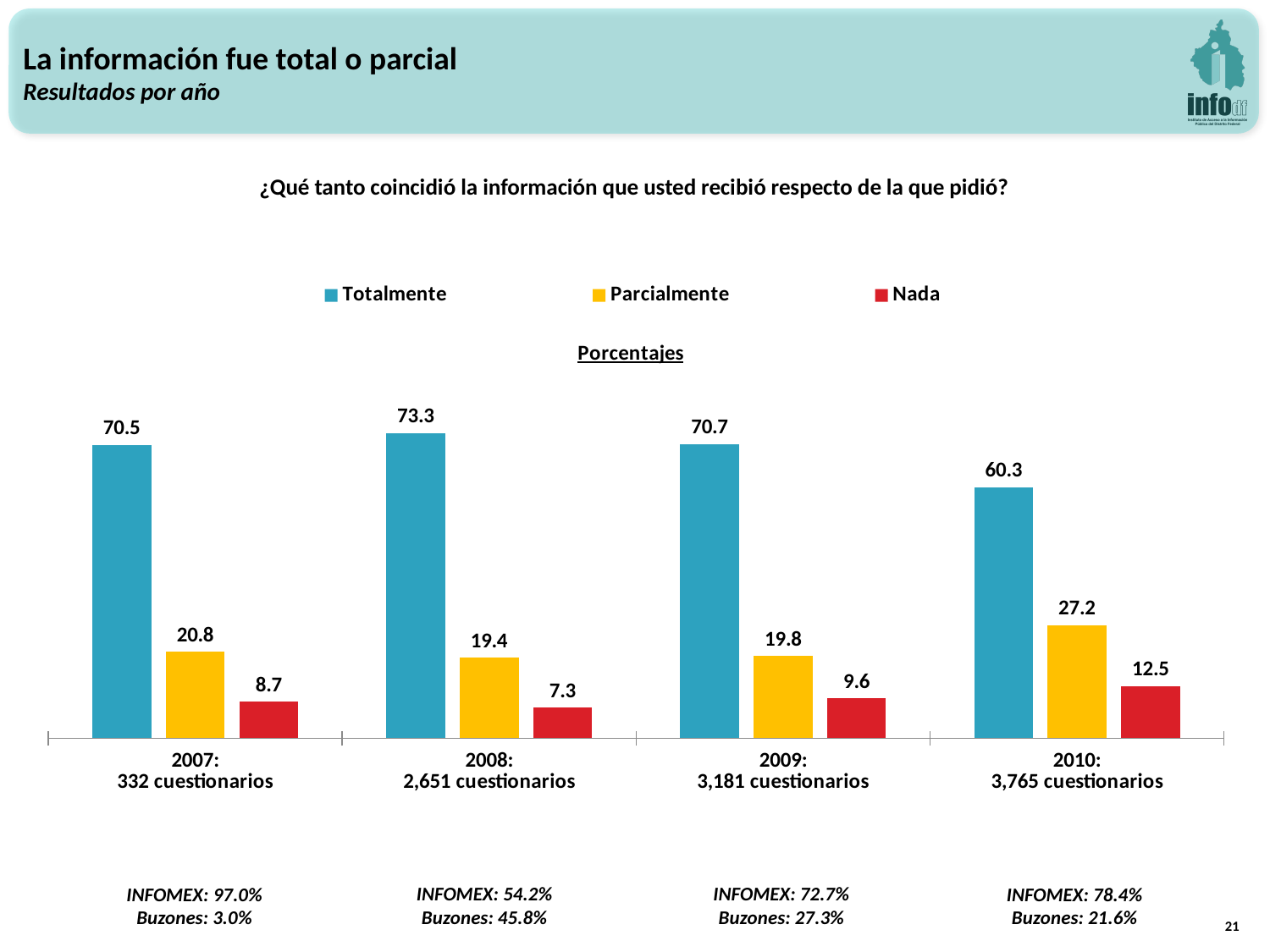
How many series does the legend list? 3 What is the value for Parcialmente in 2007? 20.8 Which colour represents the Nada series in the legend? red What is the value for Totalmente in 2008? 73.3 In which year is the Nada value lowest? 2008 What kind of chart is shown on the slide? bar chart What is the value for Nada in 2010? 12.5 What is the difference between the Totalmente values for 2008 and 2010? 13.0 Does the Parcialmente value rise or fall from 2009 to 2010? rise In which year is the Totalmente value highest? 2008 Which is larger, the Parcialmente value for 2010 or for 2009? 2010 How many years are shown on the x axis? 4